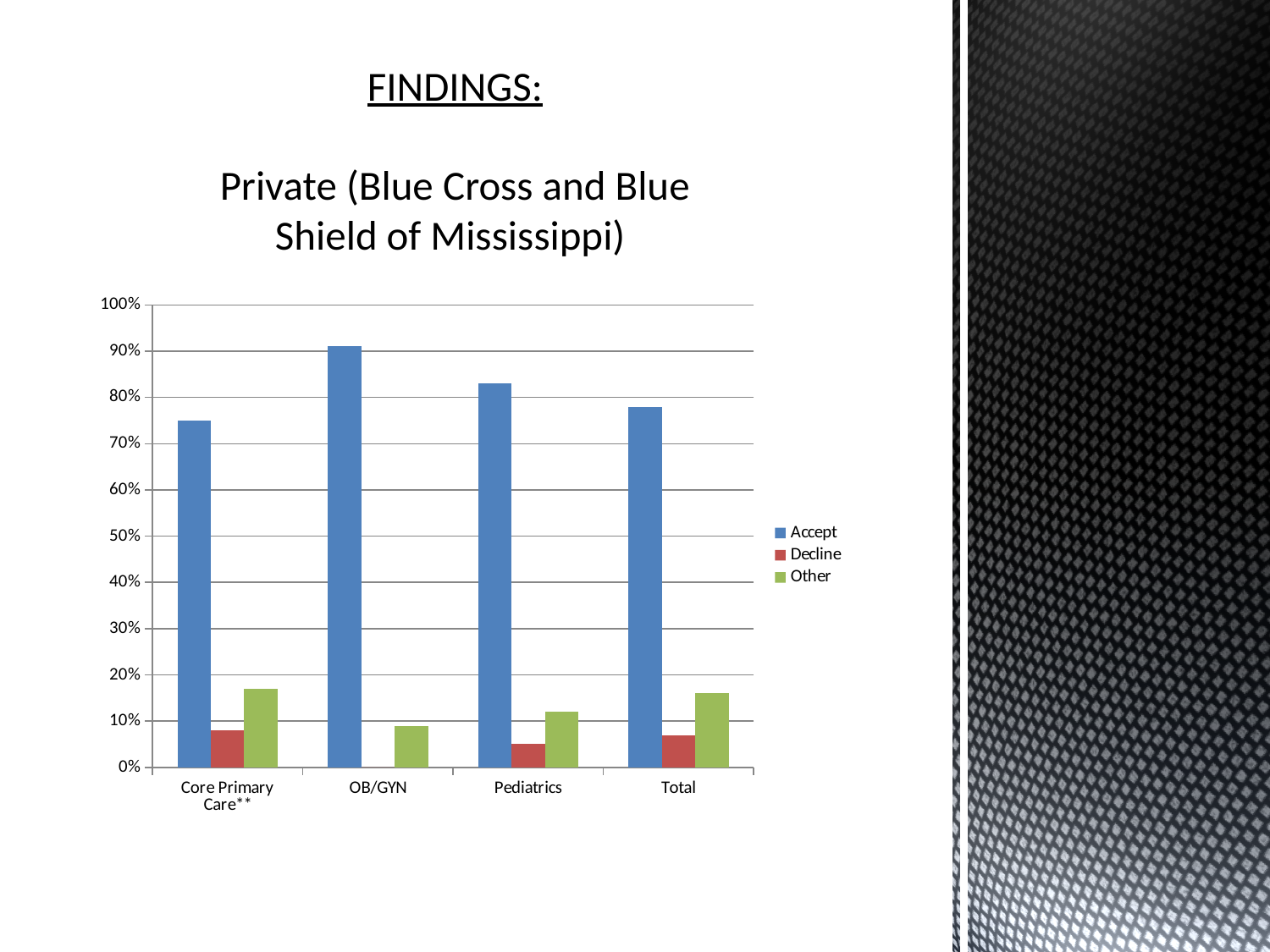
Which is larger, the Accept value for OB/GYN or the Accept value for Pediatrics? OB/GYN What are the three entries in the chart's legend? Accept, Decline, Other What kind of chart is shown on the slide? Bar chart Is the Accept value for Core Primary Care** greater or less than 80%? less How many series does the legend list? 3 Is the Other value for Core Primary Care** greater or less than 10%? greater Is the Accept value for Pediatrics greater or less than 80%? greater How many categories are shown on the x axis? 4 Which category has the lowest Other value? OB/GYN Which category has the highest Accept value? OB/GYN Which is larger, the Other value for Core Primary Care** or the Other value for Pediatrics? Core Primary Care**